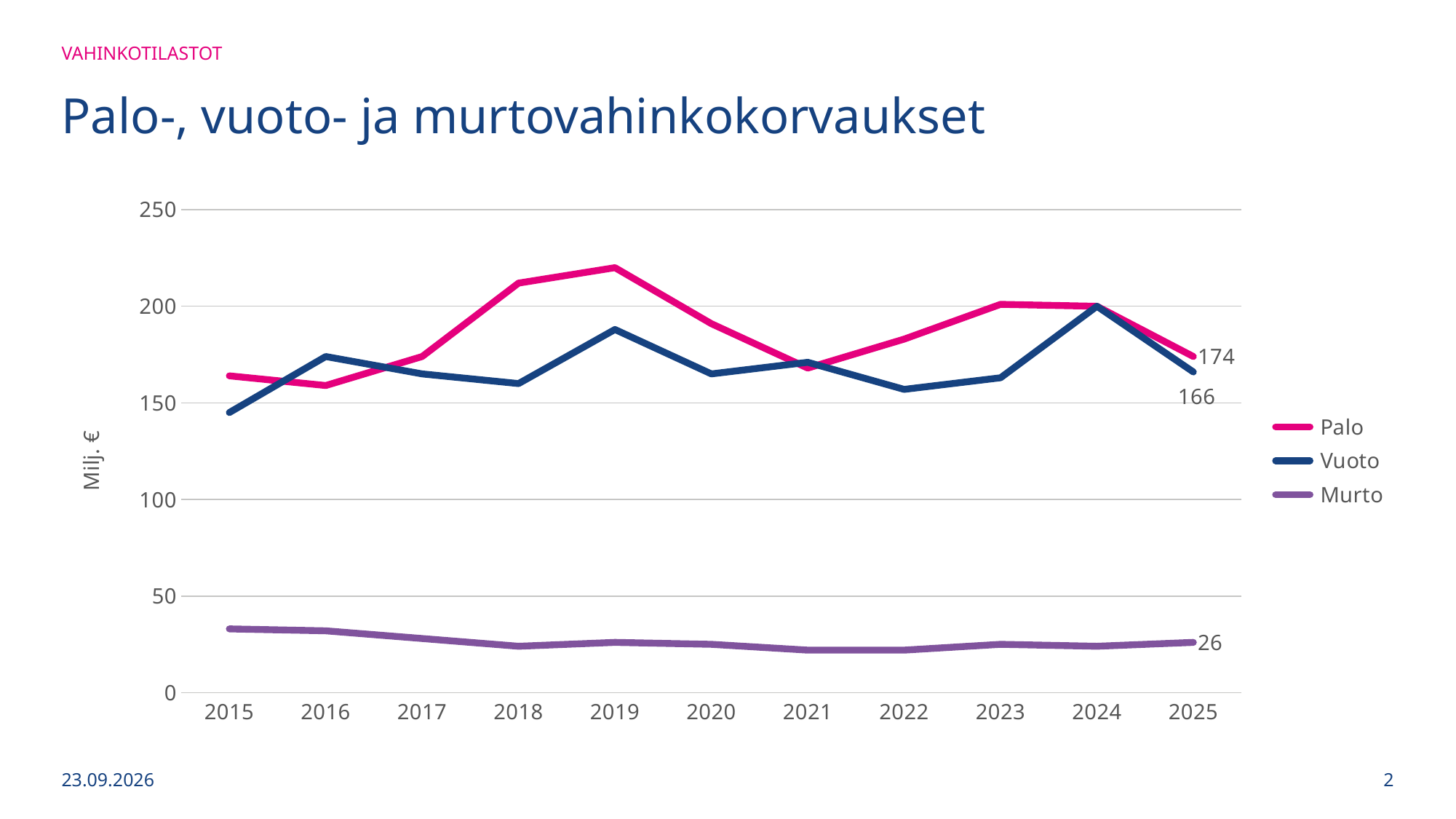
What is the value for Vuoto in 2025? 166 What is the difference between the Palo and Vuoto values in 2025? 8 Which series has the lowest values throughout the whole period? Murto Is the value for Murto in 2015 greater or less than 50? less What is the value for Palo in 2025? 174 What is the label on the y axis? Milj. € How many years are shown on the x axis? 11 How many series does the legend list? 3 Is the value for Palo in 2019 greater or less than 200? greater Which series has the higher value in 2025, Palo or Vuoto? Palo What is the value for Murto in 2025? 26 What kind of chart is shown on the slide? line chart